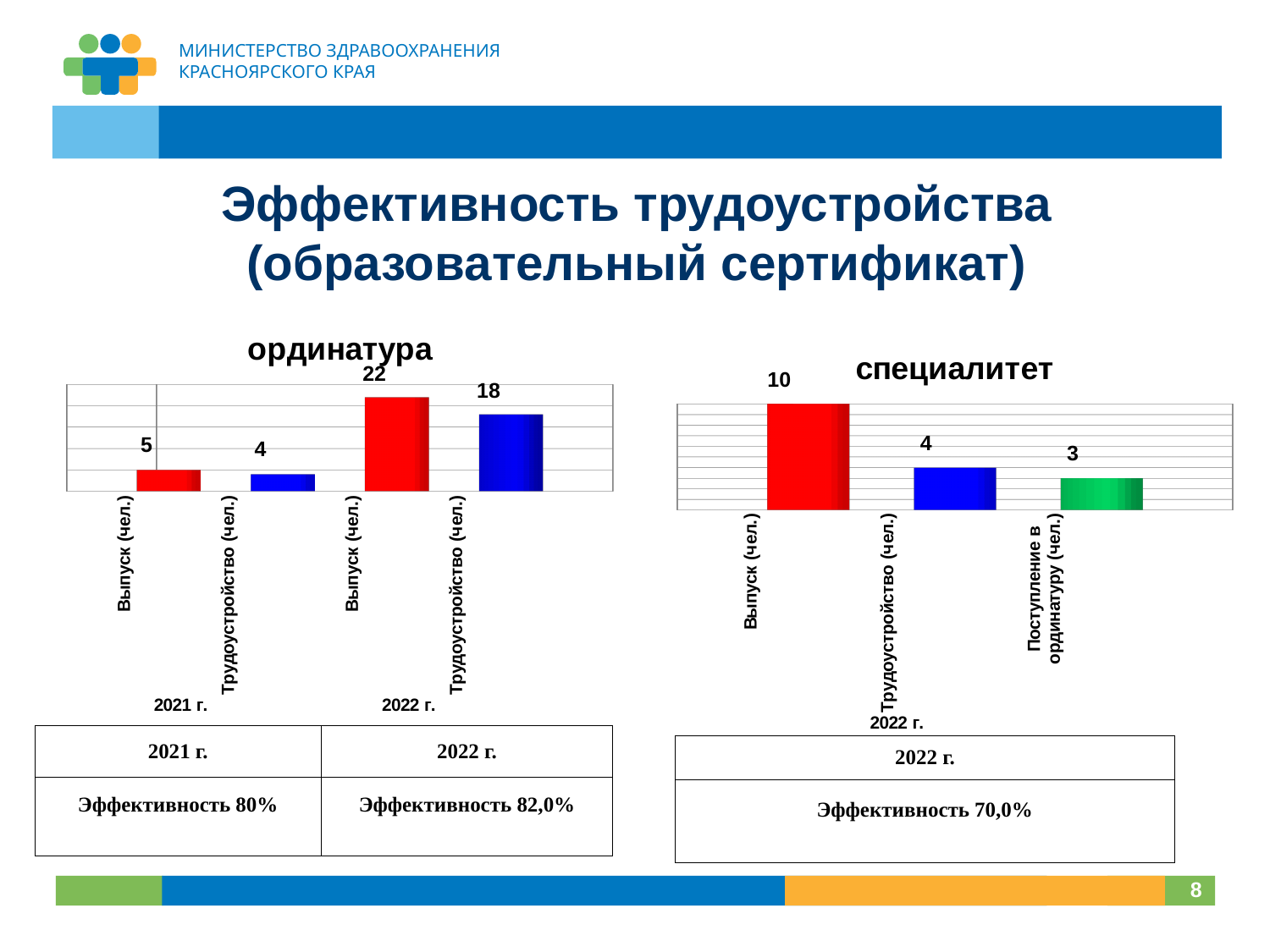
What kind of chart is the "специалитет" chart? Bar chart In the "ординатура" chart, what is the value for Выпуск (чел.) in 2022 г.? 22 In the "специалитет" chart, how many categories are plotted? 3 In the "ординатура" chart, what is the difference between Выпуск (чел.) and Трудоустройство (чел.) in 2022 г.? 4 In the "специалитет" chart, what is the value for Поступление в ординатуру (чел.)? 3 In the "специалитет" chart, which category has the lowest value? Поступление в ординатуру (чел.) In the "ординатура" chart, how many bars are plotted? 4 In the "ординатура" chart, what is the value for Трудоустройство (чел.) in 2021 г.? 4 In the "специалитет" chart, what is the difference between Выпуск (чел.) and Трудоустройство (чел.)? 6 In the "ординатура" chart, which is larger: Выпуск (чел.) in 2021 г. or Трудоустройство (чел.) in 2022 г.? Трудоустройство (чел.) in 2022 г. In the "специалитет" chart, what is the value for Выпуск (чел.)? 10 In the "ординатура" chart, which bar has the highest value? Выпуск (чел.) 2022 г.